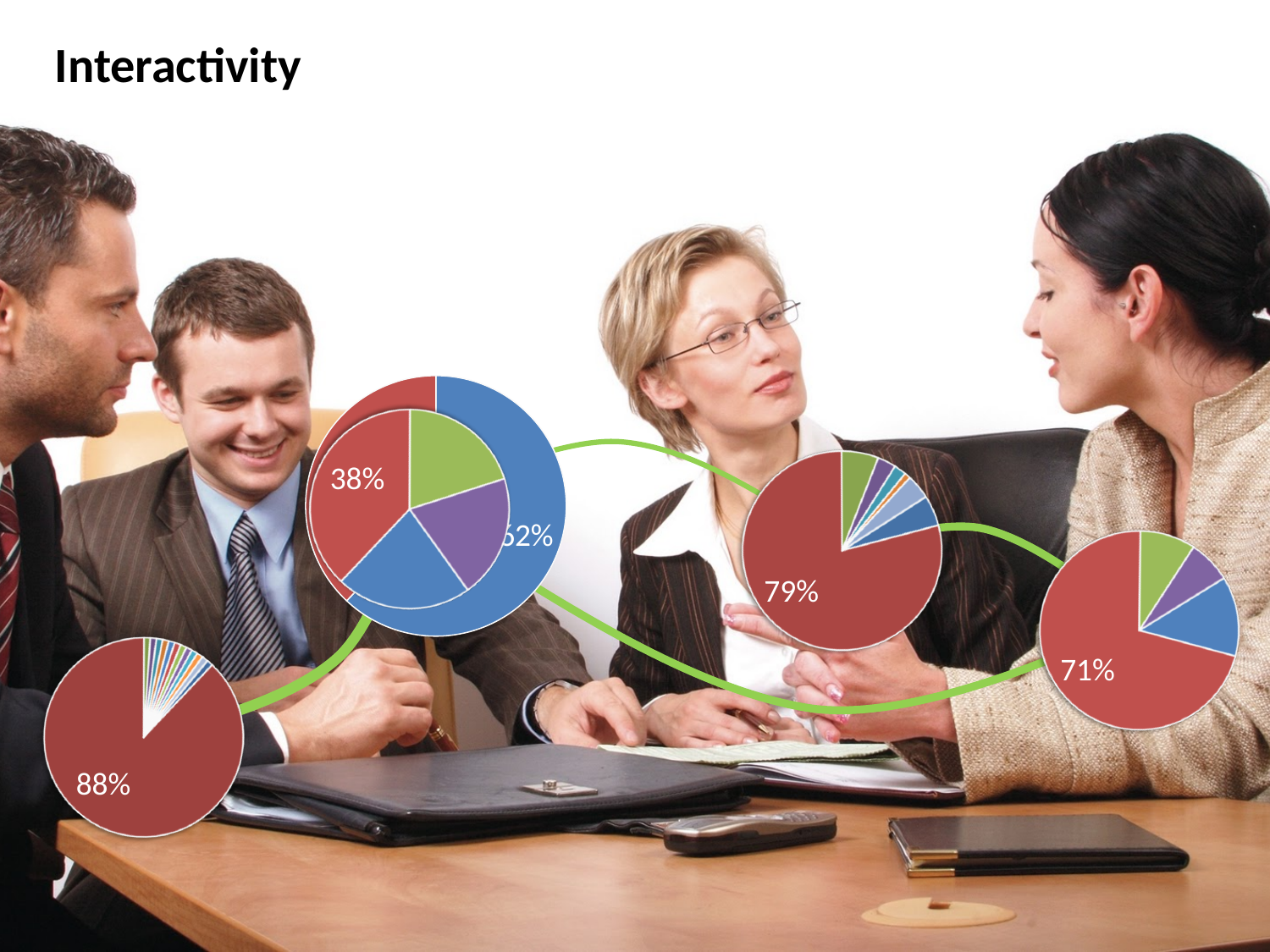
What kind of chart is the chart in the bottom-left corner of the slide? pie chart What percentage is printed on the rightmost pie chart? 71% Which is larger: the percentage printed on the bottom-left pie chart or the percentage printed on the rightmost pie chart? the bottom-left pie chart (88%) What is the difference between the percentage on the centre-right pie chart (79%) and the percentage on the rightmost pie chart (71%)? 8 percentage points What colour is the largest slice in the bottom-left pie chart? red Of the pie charts labelled 88%, 79% and 71%, which shows the smallest red share? the rightmost pie chart (71%) What percentage is printed on the pie chart in the bottom-left corner of the slide? 88% What percentage is printed on the pie chart in the centre-right of the slide, in front of the woman with glasses? 79% What is the difference between the percentage on the bottom-left pie chart (88%) and the percentage on the rightmost pie chart (71%)? 17 percentage points What percentage is printed on the red slice of the large pie chart in the left-centre of the slide? 38% What is the title of the slide containing the pie charts? Interactivity Of the pie charts labelled 88%, 79% and 71%, which shows the largest red share? the bottom-left pie chart (88%)